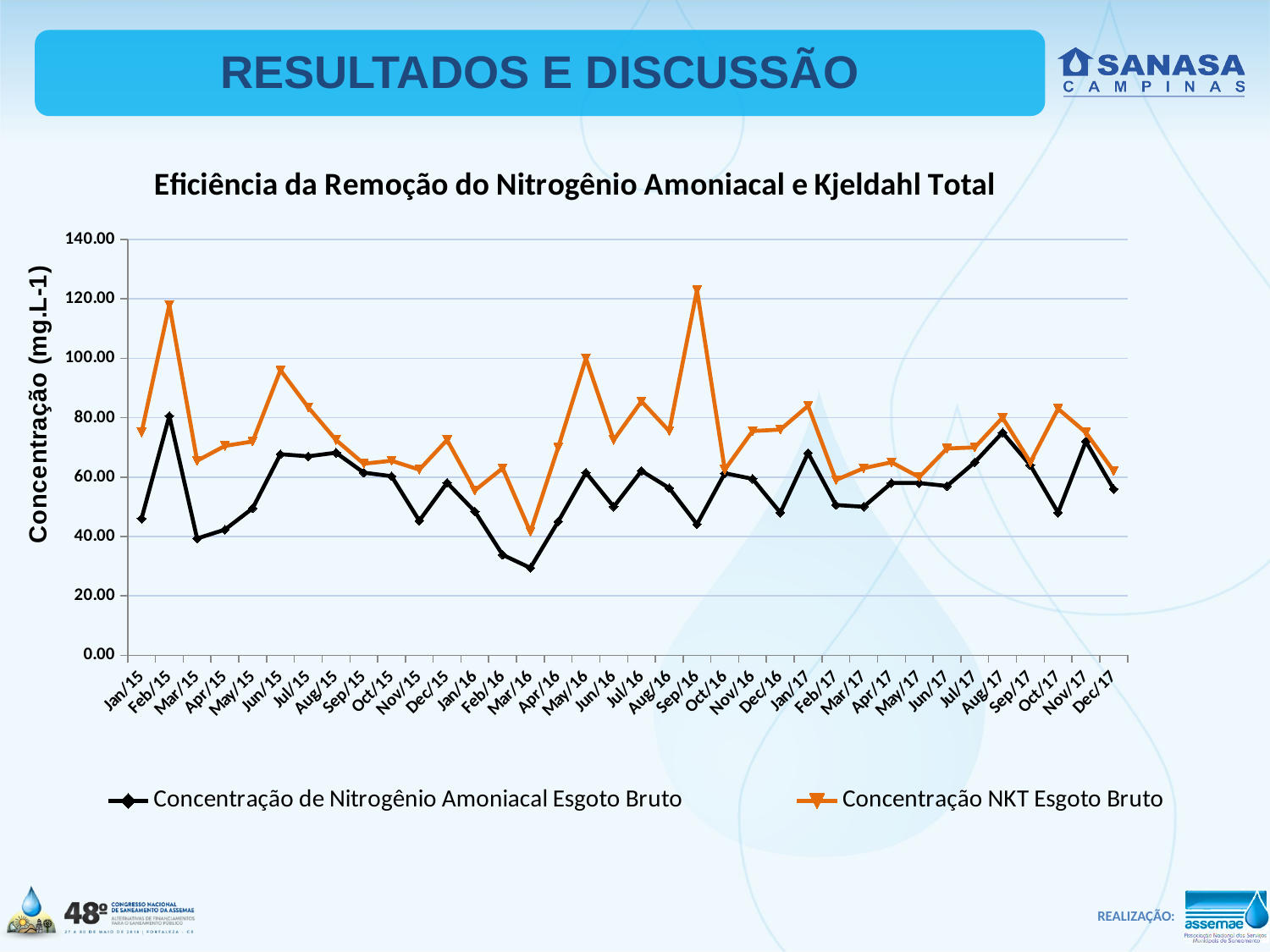
Is the value for Concentração de Nitrogênio Amoniacal Esgoto Bruto in Feb/15 greater or less than 60? greater What kind of chart is shown on the slide? Line chart In which month is the Concentração de Nitrogênio Amoniacal Esgoto Bruto series at its lowest? Mar/16 How many series does the legend list? 2 Is the value for Concentração NKT Esgoto Bruto in Mar/16 greater or less than 60? less How many monthly data points are plotted along the x axis? 36 In which month is the Concentração NKT Esgoto Bruto series at its highest? Sep/16 In Sep/16, which series has the higher value: Concentração NKT Esgoto Bruto or Concentração de Nitrogênio Amoniacal Esgoto Bruto? Concentração NKT Esgoto Bruto What is the title of the chart? Eficiência da Remoção do Nitrogênio Amoniacal e Kjeldahl Total What is the label of the y axis? Concentração (mg.L-1) Is the value for Concentração de Nitrogênio Amoniacal Esgoto Bruto in Mar/16 greater or less than 40? less